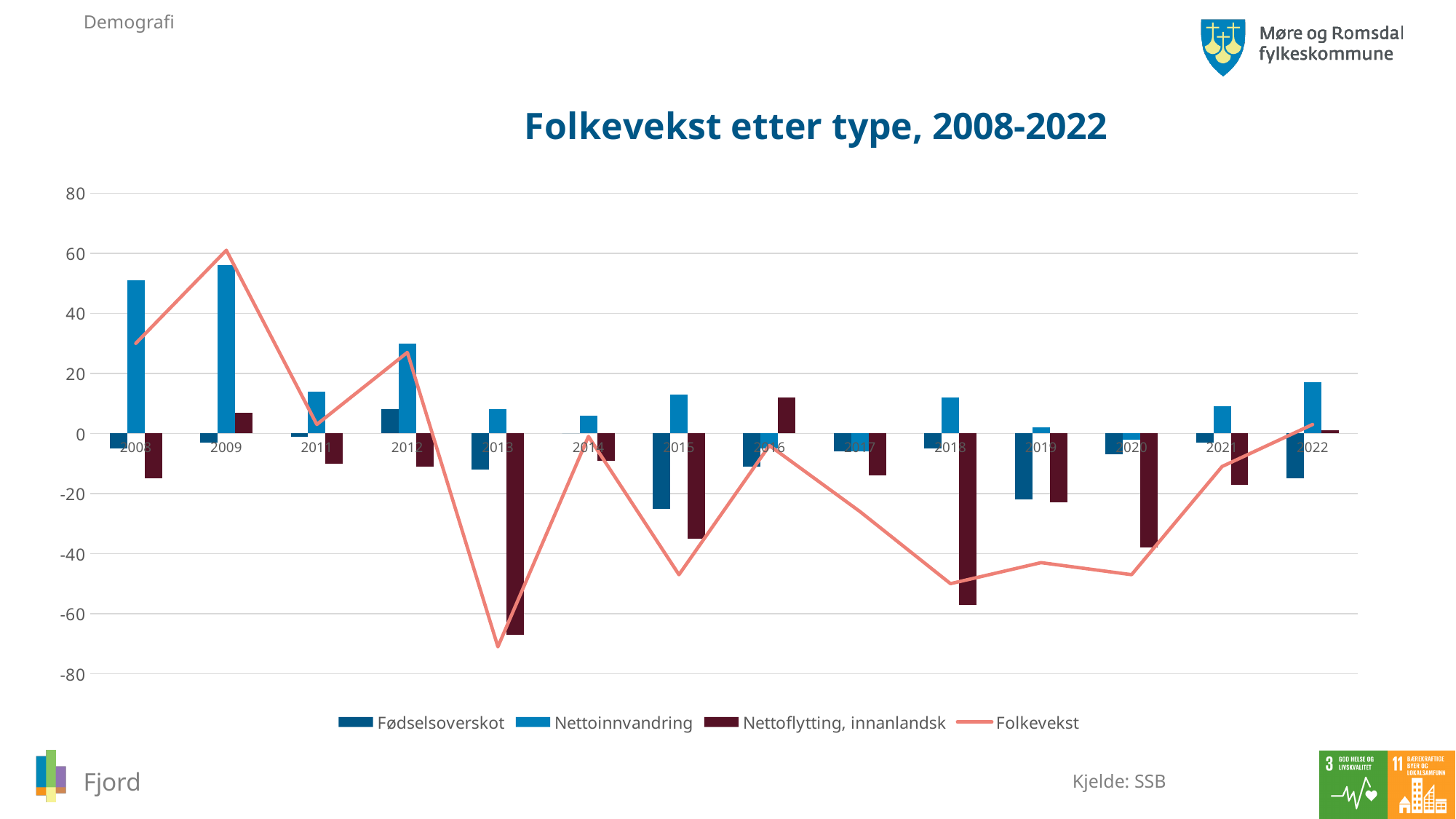
In which year is Nettoflytting, innanlandsk lowest? 2013 How many series does the legend list? 4 Is the value for Nettoinnvandring in 2008 greater or less than 40? greater Which is larger, Nettoinnvandring in 2012 or Nettoinnvandring in 2013? 2012 In which year is Nettoinnvandring highest? 2009 In which year does the Folkevekst line reach its lowest point? 2013 How many years are shown on the x axis? 14 In which year does the Folkevekst line reach its highest point? 2009 Does the Folkevekst line rise or fall from 2020 to 2022? rise Which series is drawn as a line rather than bars? Folkevekst Is the value for Nettoflytting, innanlandsk in 2013 greater or less than -60? less What kind of chart is shown on the slide? bar chart combined with a line